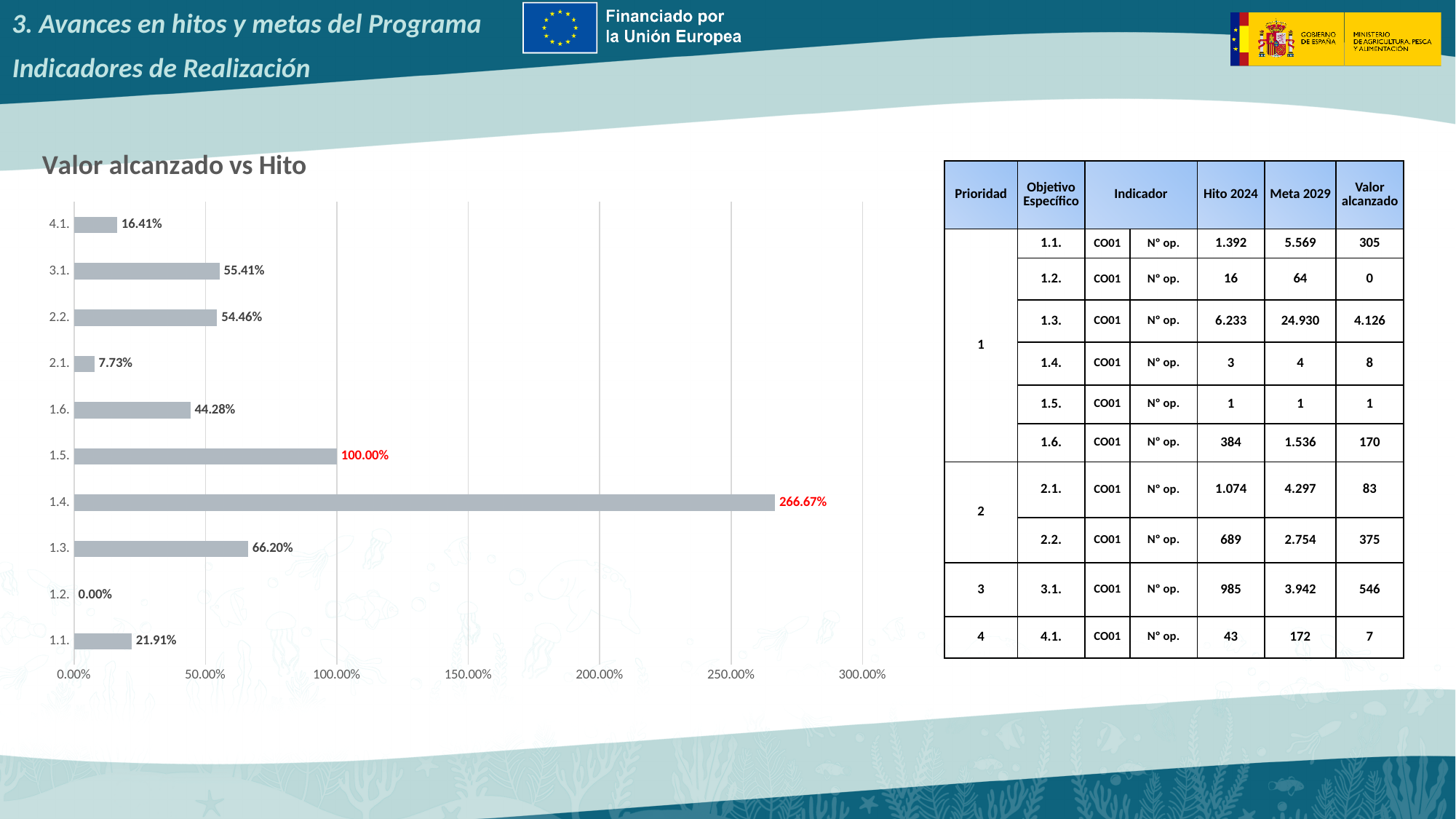
Which category has the highest value in the chart? 1.4. How many categories are shown in the chart? 10 What is the value for category 2.1. in the chart? 7.73% What is the value for category 3.1. in the chart? 55.41% What is the value for category 1.4. in the chart? 266.67% Which is larger, the value for 3.1. or the value for 2.2.? 3.1. What is the difference between the values for 1.3. and 1.6.? 21.92% Is the value for 1.5. greater or less than 50.00%? greater What kind of chart is shown on the slide? Bar chart Which two data labels in the chart are shown in red? 100.00% and 266.67% What is the title of the chart? Valor alcanzado vs Hito Which category has the lowest value in the chart? 1.2.